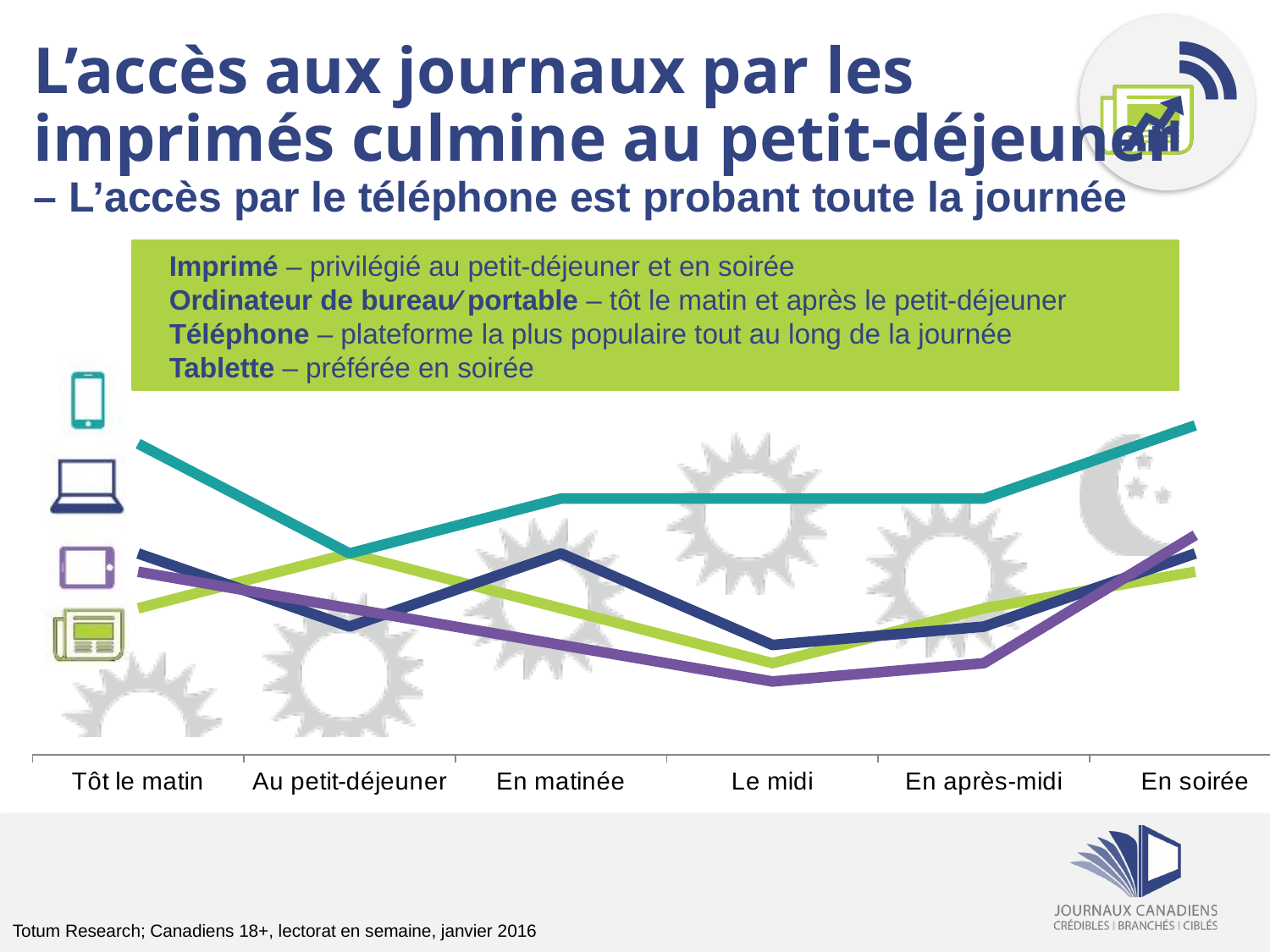
Which line is highest at 'Tôt le matin': the teal (phone) line or the green (print) line? teal (phone) At which time of day does the green (print newspaper) line reach its highest point? Au petit-déjeuner How many time-of-day categories are shown along the x axis of the chart? 6 At which time of day does the teal (phone) line reach its highest point? En soirée How many lines (series) are plotted on the chart? 4 What kind of chart is shown on the slide? line chart What is the last category on the x axis of the chart? En soirée Does the teal (phone) line rise or fall between 'Tôt le matin' and 'Au petit-déjeuner'? fall At which time of day does the purple (tablet) line reach its lowest point? Le midi At which time of day does the green (print newspaper) line reach its lowest point? Le midi Does the teal (phone) line rise or fall between 'En après-midi' and 'En soirée'? rise What is the first category on the x axis of the chart? Tôt le matin